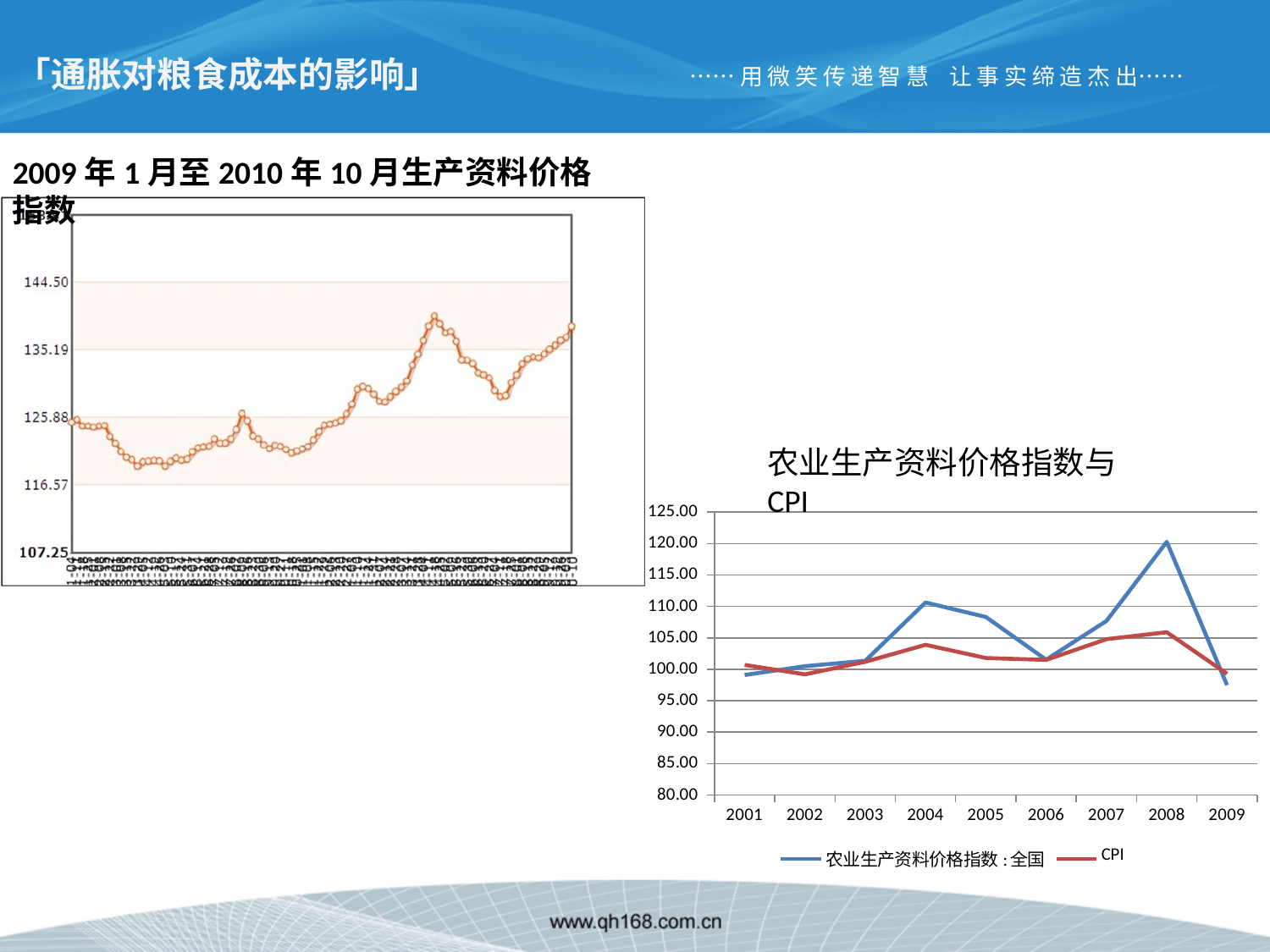
In the chart on the left of the slide (2009年1月至2010年10月生产资料价格指数), is the highest point of the line greater or less than 135.19? greater In the chart titled 农业生产资料价格指数与CPI, is the 2009 value for 农业生产资料价格指数:全国 greater or less than 100.00? less What kind of chart is the chart on the left of the slide (2009年1月至2010年10月生产资料价格指数)? line chart In the chart titled 农业生产资料价格指数与CPI, which series has the larger value in 2008, 农业生产资料价格指数:全国 or CPI? 农业生产资料价格指数:全国 In the chart titled 农业生产资料价格指数与CPI, what colour is the CPI line? red In the chart titled 农业生产资料价格指数与CPI, in which year does 农业生产资料价格指数:全国 reach its highest value? 2008 In the chart titled 农业生产资料价格指数与CPI, does 农业生产资料价格指数:全国 rise or fall from 2008 to 2009? fall In the chart titled 农业生产资料价格指数与CPI, is the 2004 value for 农业生产资料价格指数:全国 greater or less than 105.00? greater How many series does the legend of the chart titled 农业生产资料价格指数与CPI list? 2 How many years are shown on the x axis of the chart titled 农业生产资料价格指数与CPI? 9 What kind of chart is the chart titled 农业生产资料价格指数与CPI? line chart